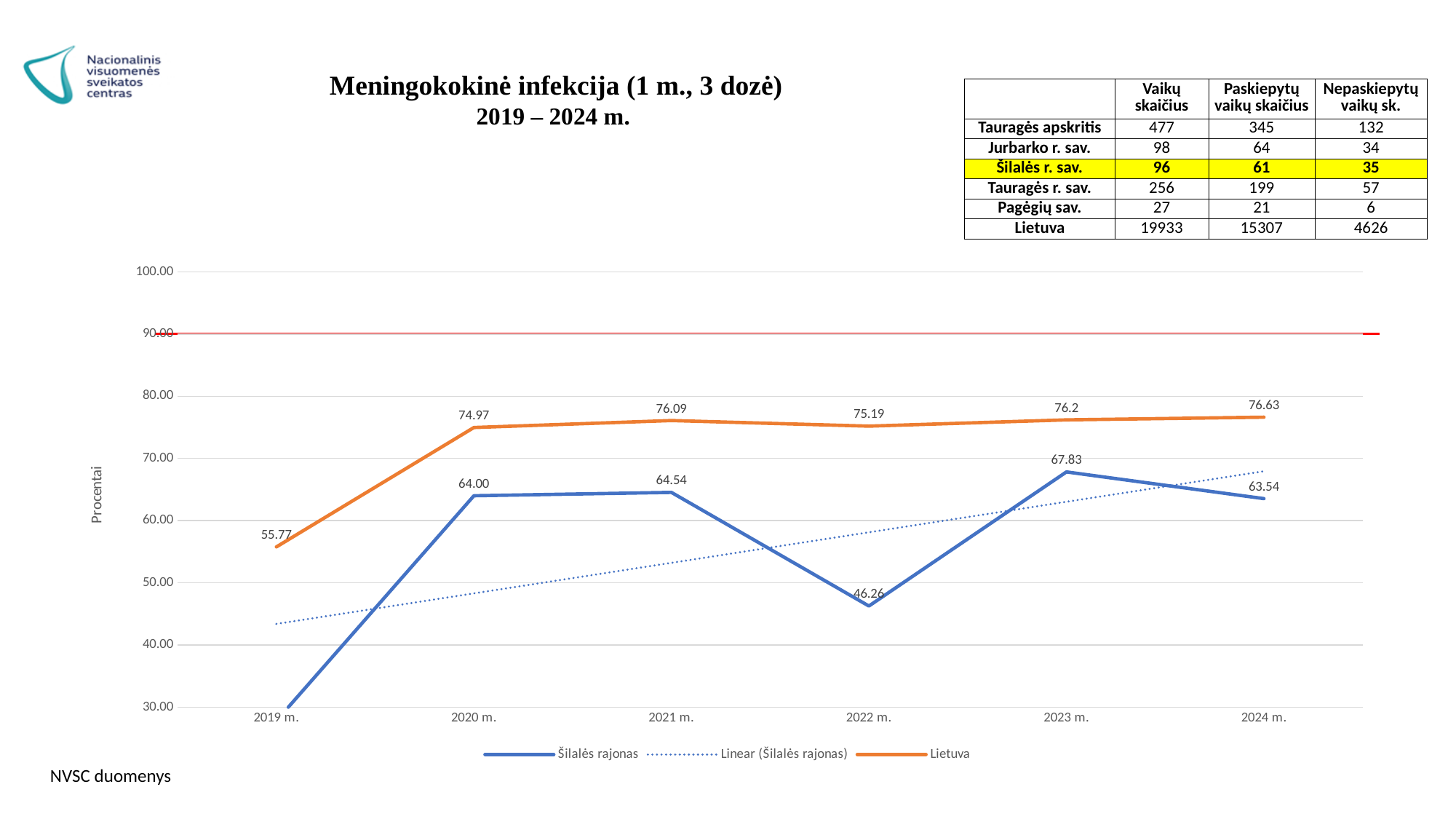
What is the value for Šilalės rajonas in 2022 m.? 46.26 How many entries does the chart legend list? 3 In which year is the Lietuva value the highest? 2024 m. How many years are shown on the x axis of the chart? 6 What type of chart is shown on the slide? line chart Which is larger in 2021 m., the value for Lietuva or for Šilalės rajonas? Lietuva What is the value for Šilalės rajonas in 2023 m.? 67.83 In which year is the Lietuva value the lowest? 2019 m. Is the value for Šilalės rajonas in 2019 m. greater or less than 40.00? less What is the difference between the Lietuva and Šilalės rajonas values in 2022 m.? 28.93 What is the value for Lietuva in 2020 m.? 74.97 What is the value for Lietuva in 2024 m.? 76.63